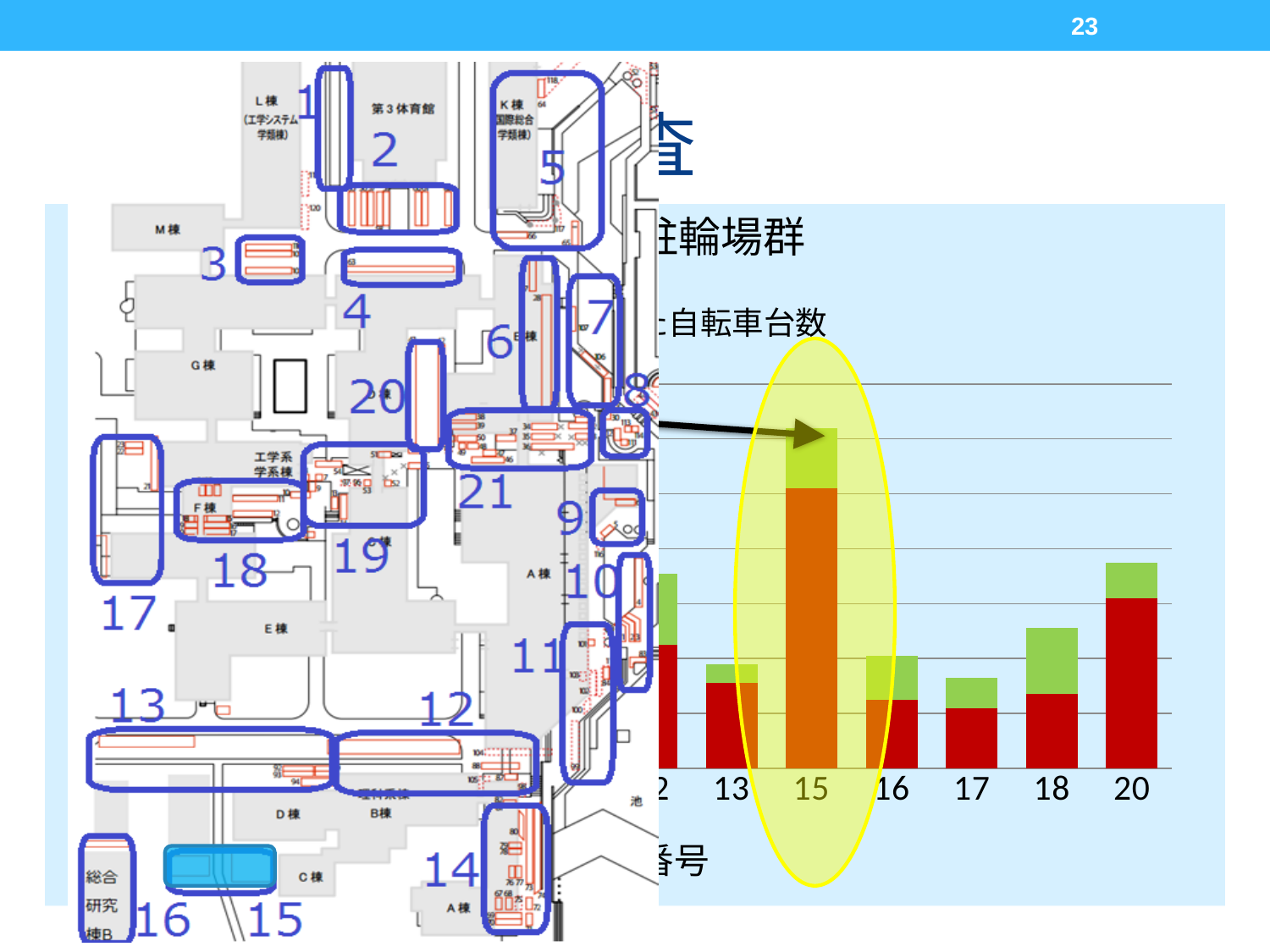
Which bar is taller, category 15 or category 20? 15 Which bar is taller, category 18 or category 17? 18 What kind of chart is shown on the right side of the slide? bar chart Which bar is taller, category 20 or category 18? 20 What colour is the lower segment of the bar for category 15? orange Which category on the x axis is highlighted with a yellow ellipse? 15 Which category has the tallest bar in the chart? 15